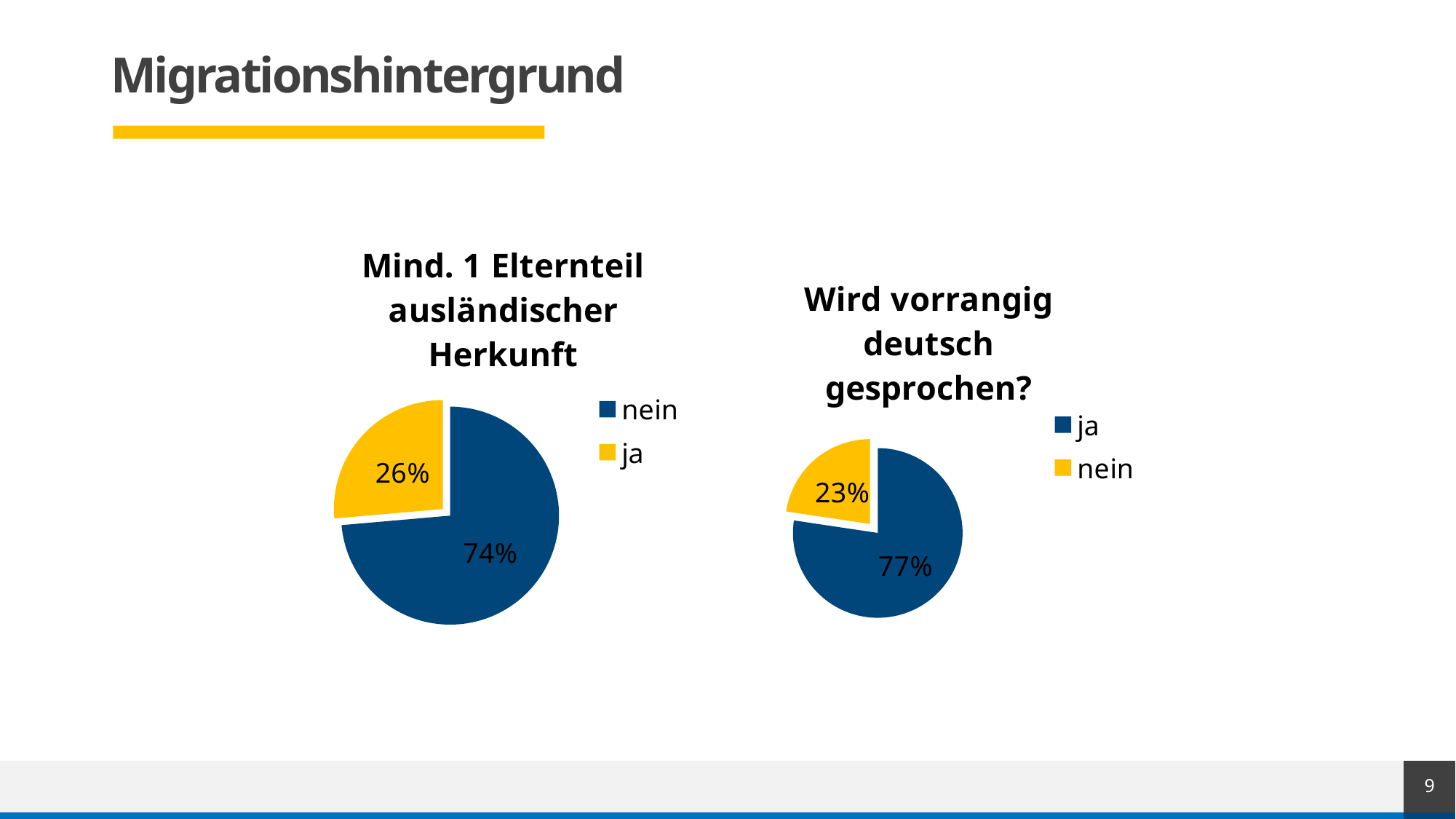
In the chart titled "Wird vorrangig deutsch gesprochen?", which slice is the smallest? nein Which is larger: the "ja" slice in the left chart or the "nein" slice in the right chart? the "ja" slice in the left chart In the chart titled "Mind. 1 Elternteil ausländischer Herkunft", what share of the pie is "nein"? 74% In the chart titled "Mind. 1 Elternteil ausländischer Herkunft", which slice is the largest? nein In the chart titled "Mind. 1 Elternteil ausländischer Herkunft", what is the difference in percentage points between the "nein" and "ja" slices? 48 How many slices does the chart titled "Wird vorrangig deutsch gesprochen?" have? 2 What type of chart is used on this slide? pie chart In the chart titled "Wird vorrangig deutsch gesprochen?", what share of the pie is "nein"? 23% In the chart titled "Mind. 1 Elternteil ausländischer Herkunft", what colour is the "ja" slice? yellow In the chart titled "Wird vorrangig deutsch gesprochen?", what share of the pie is "ja"? 77% In the chart titled "Wird vorrangig deutsch gesprochen?", what is the difference in percentage points between the "ja" and "nein" slices? 54 In the chart titled "Mind. 1 Elternteil ausländischer Herkunft", what share of the pie is "ja"? 26%